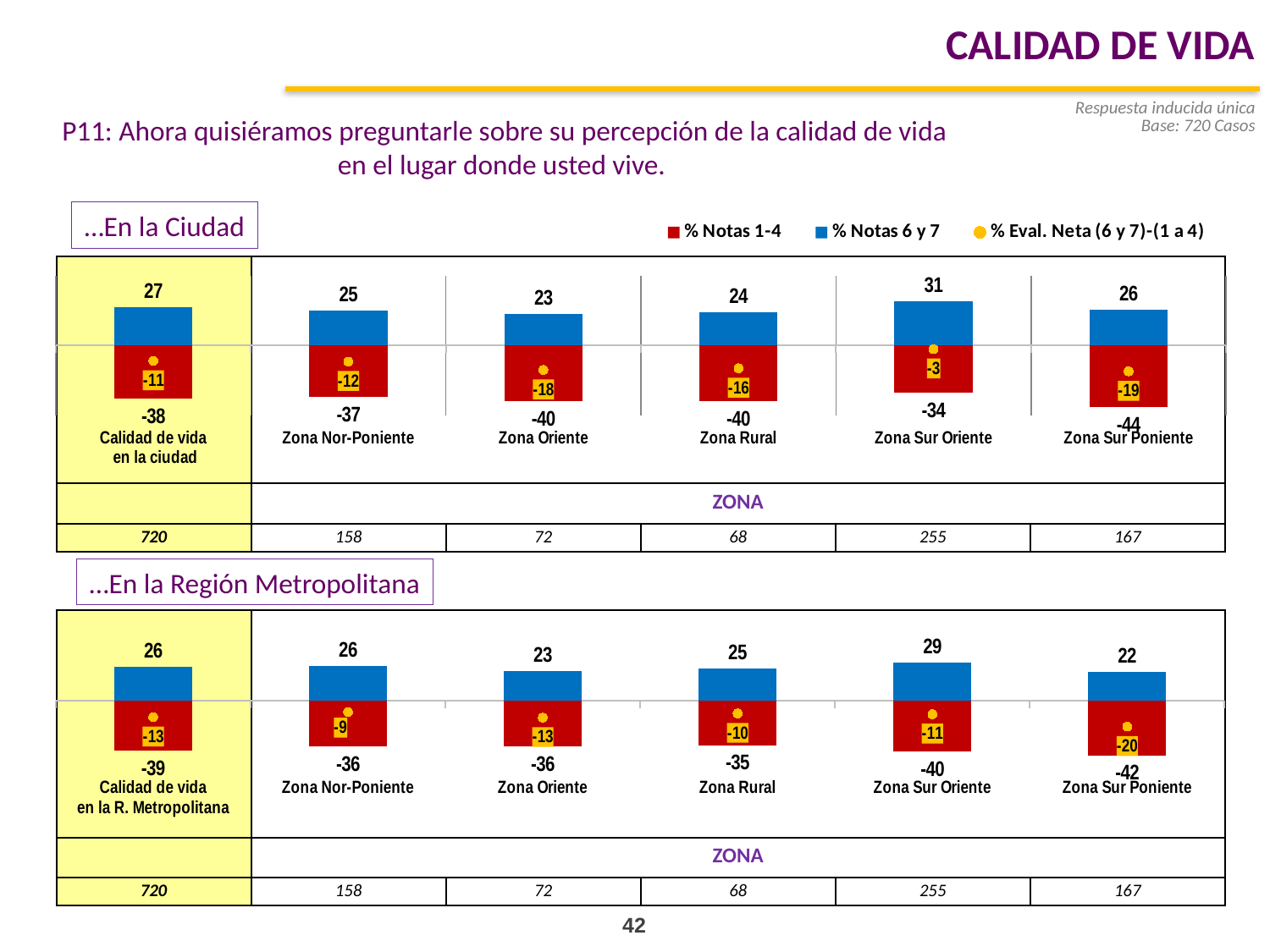
In the '...En la Región Metropolitana' chart, what is the % Eval. Neta value for Zona Nor-Poniente? -9 In the '...En la Ciudad' chart, what is the % Notas 6 y 7 value for Zona Sur Oriente? 31 In the '...En la Ciudad' chart, what is the % Eval. Neta value for Zona Oriente? -18 In the '...En la Región Metropolitana' chart, which is larger, the % Notas 6 y 7 value for Zona Sur Oriente or for Zona Oriente? Zona Sur Oriente In the '...En la Región Metropolitana' chart, which zone has the lowest % Notas 6 y 7 value? Zona Sur Poniente In the '...En la Ciudad' chart, which zone has the highest % Notas 6 y 7 value? Zona Sur Oriente What kind of chart is the '...En la Ciudad' chart? Bar chart In the '...En la Ciudad' chart, what is the difference between the % Notas 6 y 7 values for Zona Sur Oriente and Zona Oriente? 8 How many series does the legend list for the charts on this slide? 3 In the '...En la Región Metropolitana' chart, what is the % Notas 1-4 value for Zona Rural? -35 In the '...En la Región Metropolitana' chart, what is the % Notas 6 y 7 value for Zona Sur Poniente? 22 In the '...En la Ciudad' chart, what is the % Notas 1-4 value for Zona Sur Poniente? -44